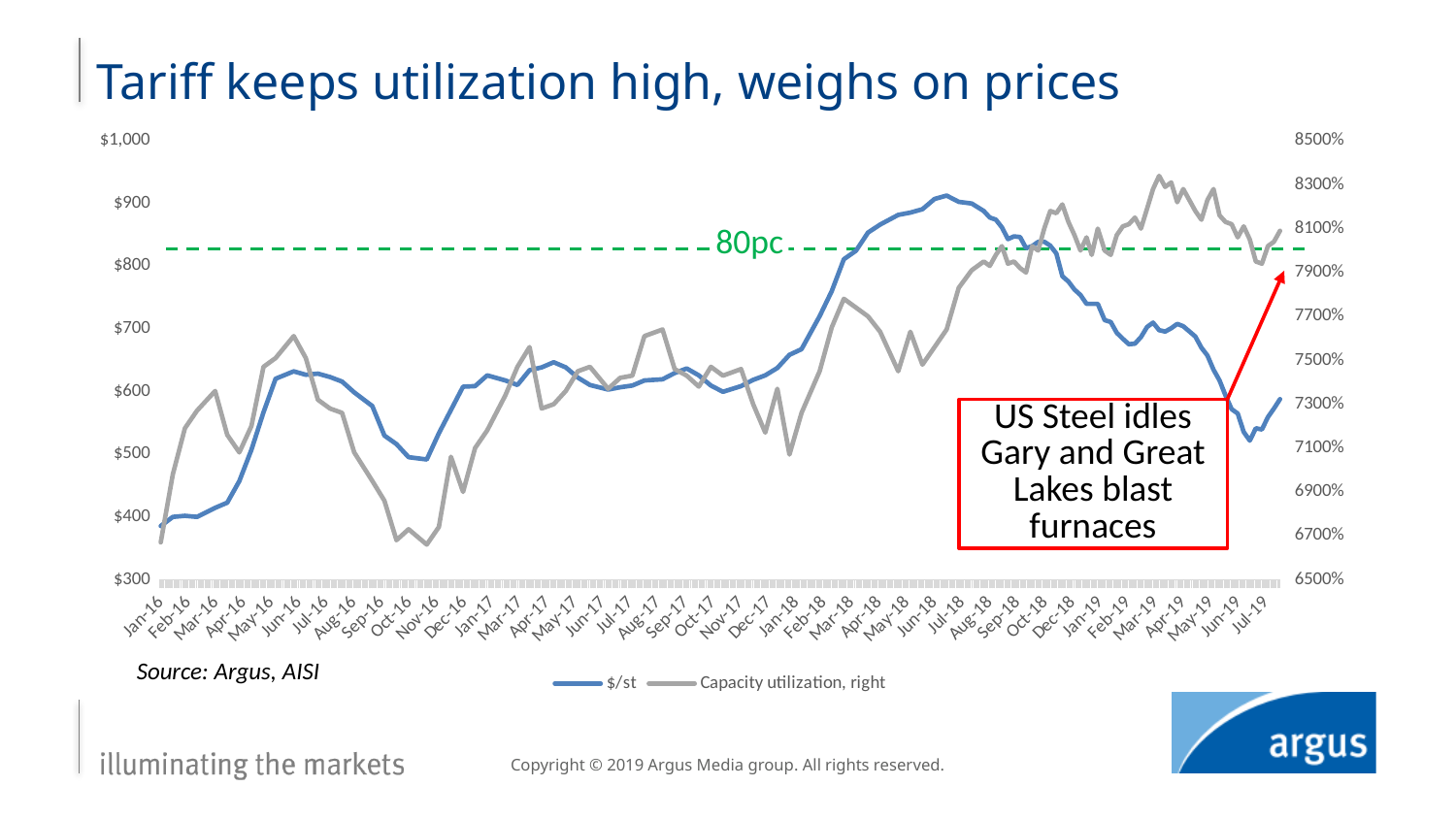
What kind of chart is shown on the slide? line chart Is the capacity utilization value in Oct-16 greater or less than 6900%? less Is the capacity utilization value in Mar-19 greater or less than 8100%? greater What label is written on the dashed green horizontal line? 80pc In which month is the $/st series at its lowest? Jan-16 Does the $/st series rise or fall between Jan-16 and Jun-16? rise Which is higher for the $/st series: the value in Jun-18 or the value in Jun-19? Jun-18 What are the two series named in the legend? $/st and Capacity utilization, right How many series does the legend list? 2 Is the $/st value in Jun-18 greater or less than $800? greater Does the $/st series rise or fall between Jun-18 and Jun-19? fall